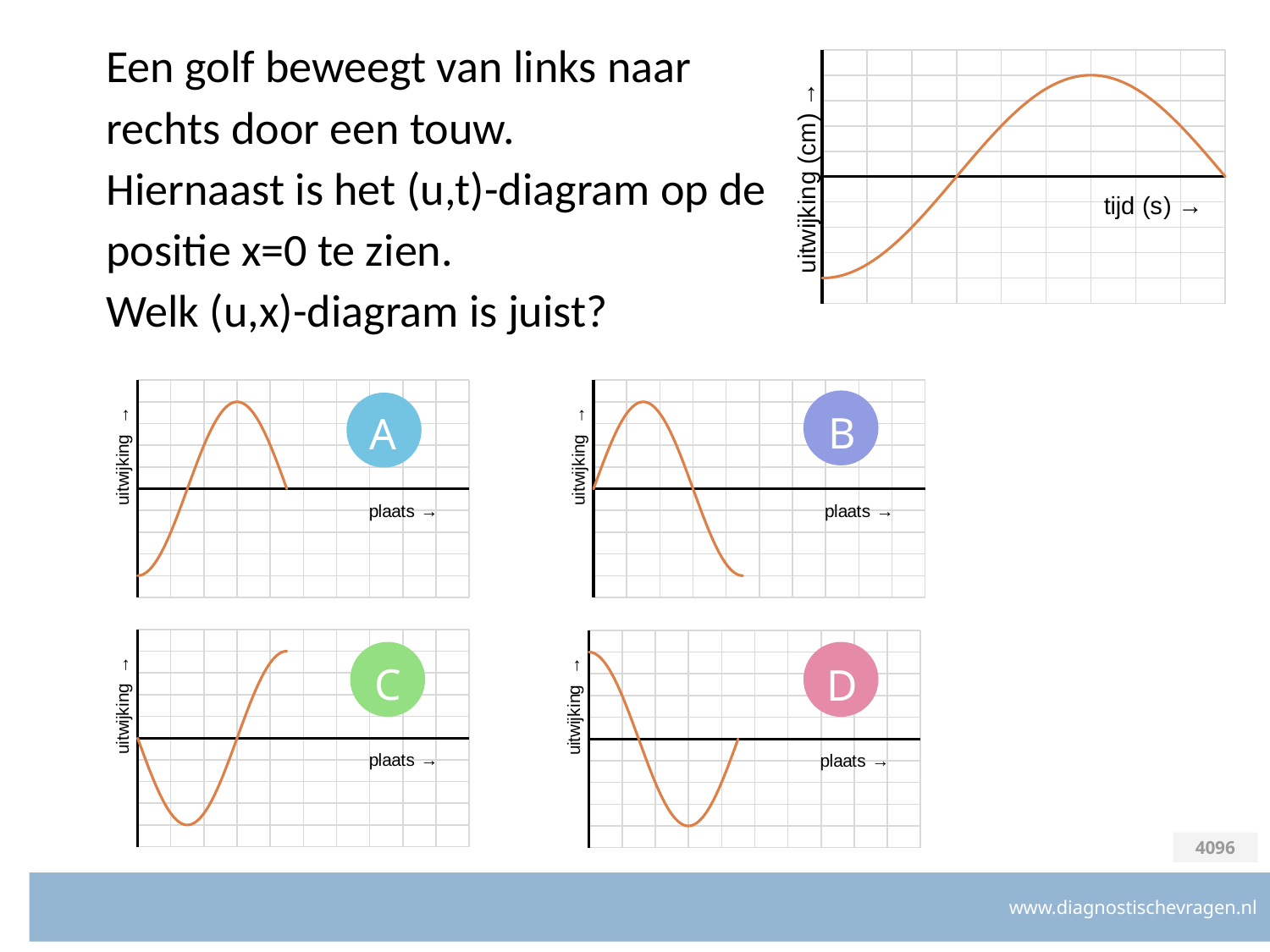
In diagram B, does the curve first rise then fall, or first fall then rise, along the plaats axis? first rise then fall In diagram D, does the curve rise or fall at the right end of the plotted line? rise What kind of chart is diagram A? line chart In the (u,t)-diagram at the top right, does the curve rise or fall at the start of the time axis? rise What kind of chart is the (u,t)-diagram at the top right of the slide? line chart What is the label on the horizontal axis of the (u,t)-diagram at the top right? tijd (s) What is the label on the horizontal axis of diagrams A, B, C and D? plaats